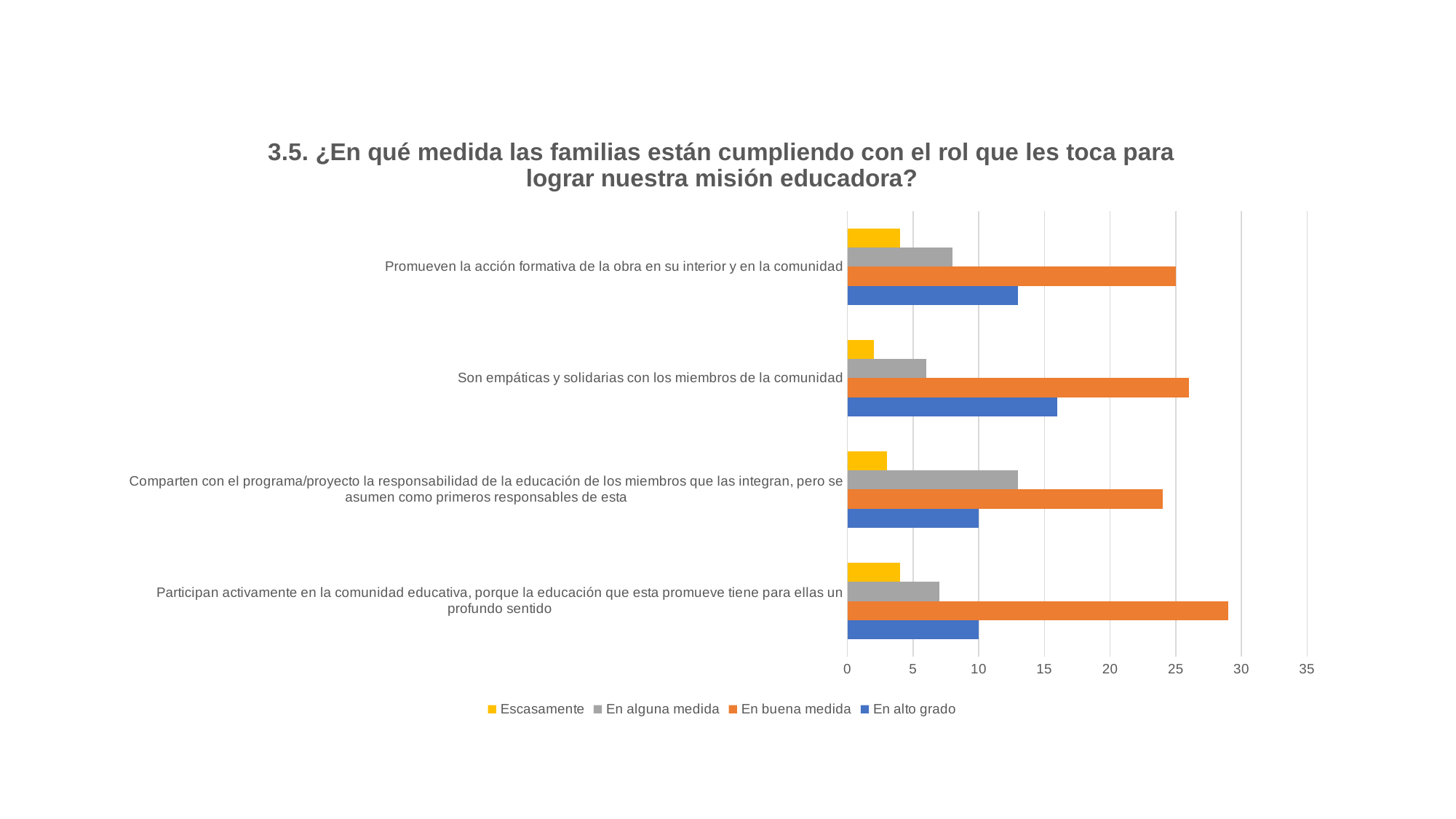
How many categories (statements) are plotted on the chart? 4 Which is larger for "Son empáticas y solidarias con los miembros de la comunidad": "En buena medida" or "En alto grado"? En buena medida Is the value of "En alto grado" for "Son empáticas y solidarias con los miembros de la comunidad" greater or less than 15? greater Which category has the highest "En buena medida" value? Participan activamente en la comunidad educativa, porque la educación que esta promueve tiene para ellas un profundo sentido What is the value of "En alto grado" for "Comparten con el programa/proyecto la responsabilidad de la educación de los miembros que las integran, pero se asumen como primeros responsables de esta"? 10 Which series is shown in orange in the legend? En buena medida How many series does the legend list? 4 Is the value of "Escasamente" for "Son empáticas y solidarias con los miembros de la comunidad" greater or less than 5? less What is the value of "En buena medida" for "Promueven la acción formativa de la obra en su interior y en la comunidad"? 25 What kind of chart is shown on the slide? Bar chart Is the value of "En buena medida" for "Participan activamente en la comunidad educativa..." greater or less than 25? greater What is the value of "En alto grado" for "Participan activamente en la comunidad educativa, porque la educación que esta promueve tiene para ellas un profundo sentido"? 10